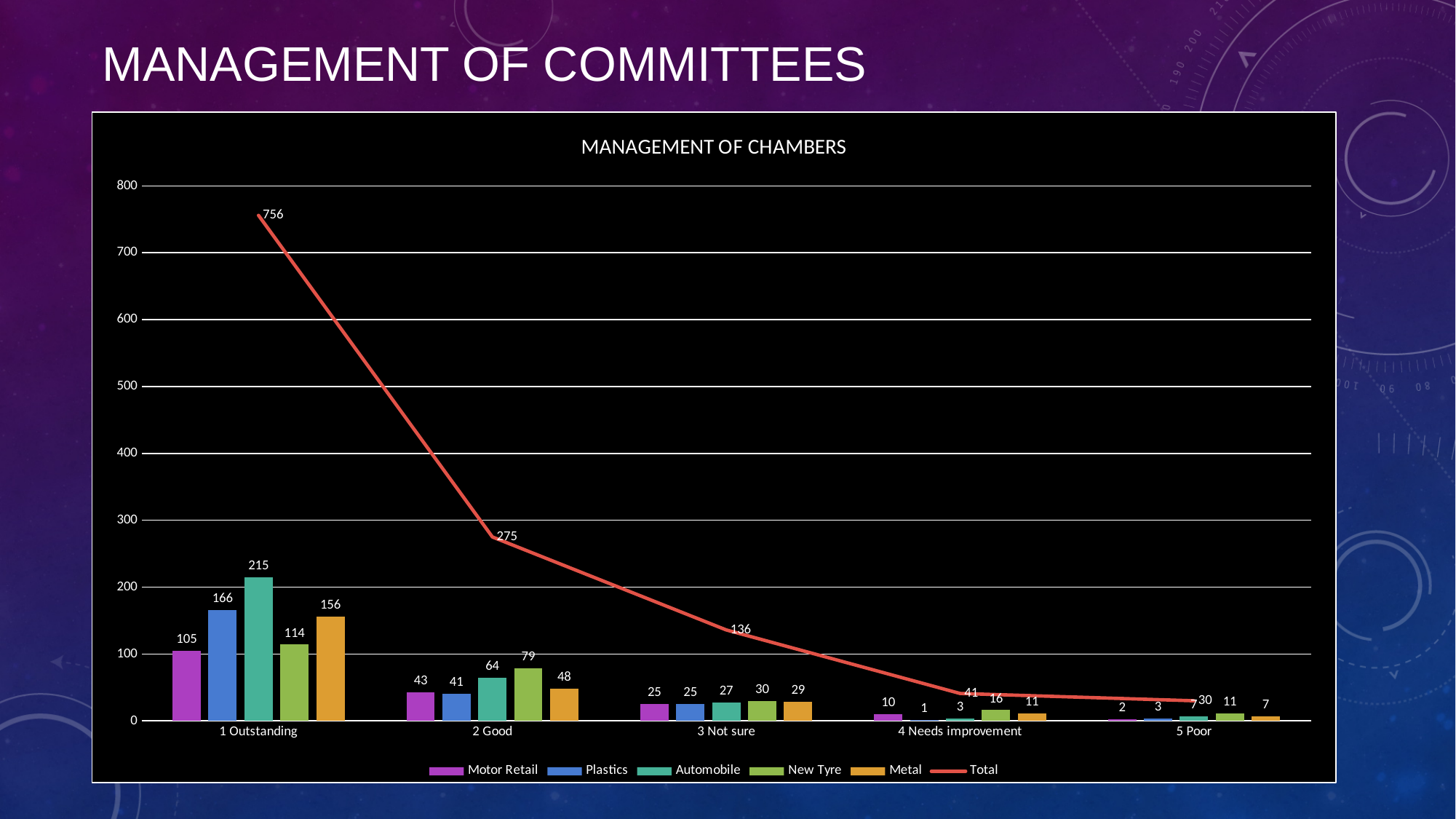
What is the Automobile value for 1 Outstanding? 215 How many categories are shown on the x axis? 5 Which category has the highest Total value? 1 Outstanding What is the chart title? MANAGEMENT OF CHAMBERS Which is larger for 1 Outstanding: Plastics or Metal? Plastics What is the New Tyre value for 4 Needs improvement? 16 What is the Total value for 2 Good? 275 What is the Plastics value for 4 Needs improvement? 1 Which category has the lowest Total value? 5 Poor What is the difference between the Total for 1 Outstanding and the Total for 2 Good? 481 Does the Total line rise or fall from 1 Outstanding to 5 Poor? fall How many series does the legend list? 6